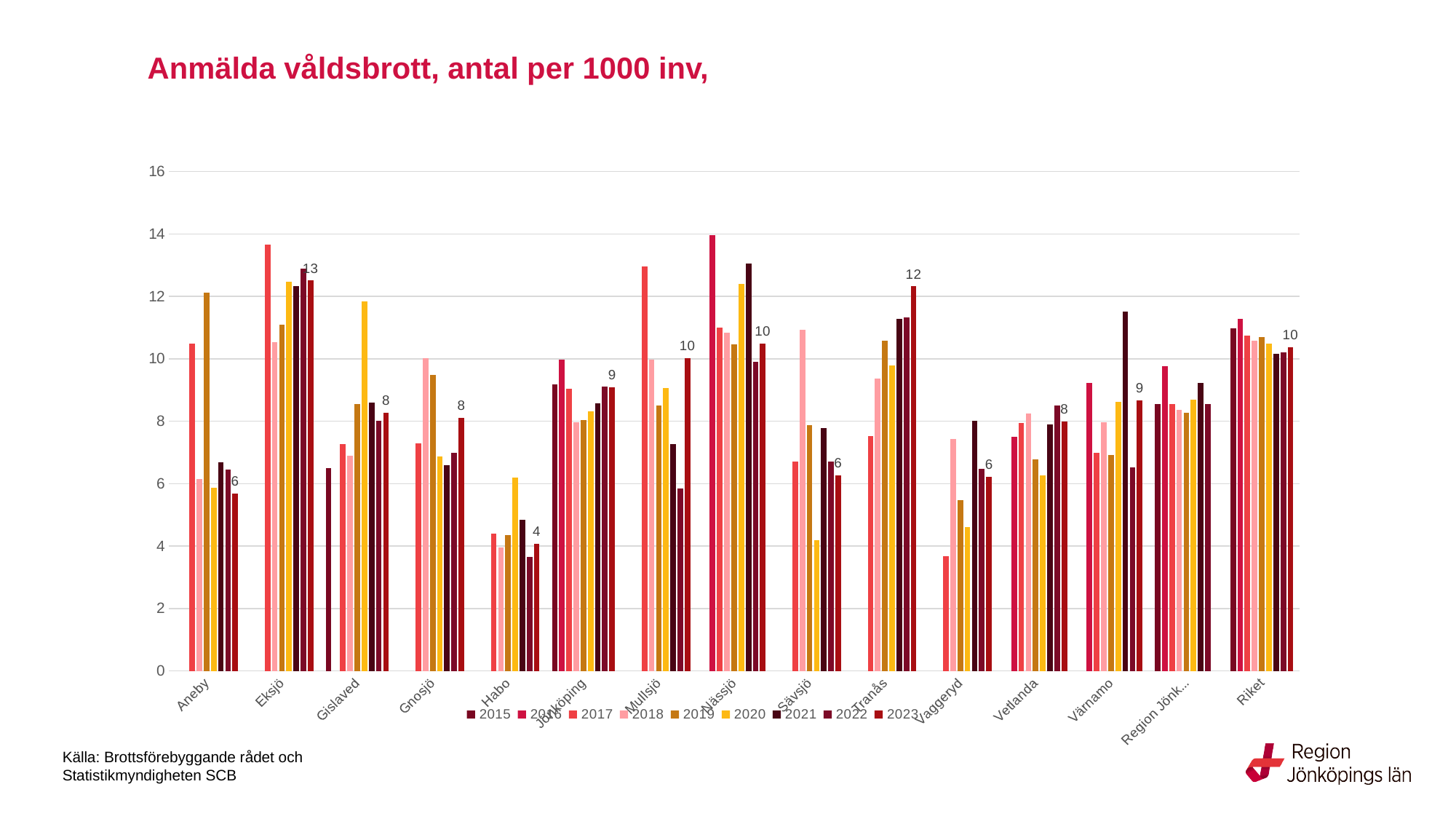
What is the difference between the 2023 values for Eksjö and Habo? 9 What is the 2023 value for Habo? 4 How many series does the legend list? 9 What is the 2023 value for Eksjö? 13 How many categories are shown on the x axis? 15 Is the 2017 value for Nässjö greater or less than 12? less What kind of chart is shown on the slide? Bar chart Among the labelled 2023 values, which municipality has the lowest value? Habo Among the labelled 2023 values, which municipality has the highest value? Eksjö Which has the larger 2023 value, Tranås or Vaggeryd? Tranås What is the 2023 value for Tranås? 12 What is the 2023 value for Riket? 10